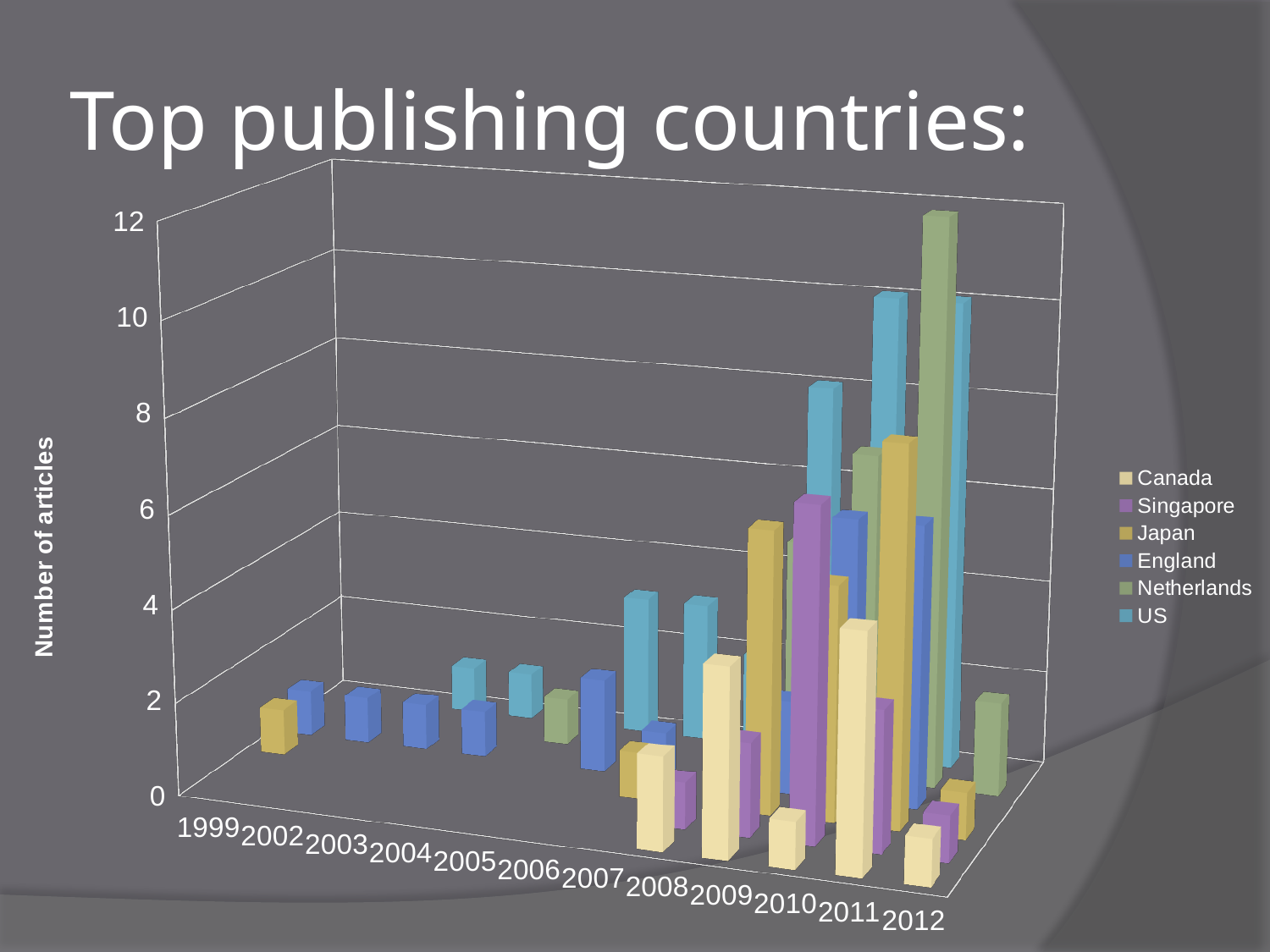
What kind of chart is shown on the slide? bar chart Is the value for US in 2011 greater or less than 8? greater How many series does the legend list? 6 Which country has the tallest bar in 2012? Netherlands Is the value for Netherlands in 2012 greater or less than 10? less How many years are shown along the x axis? 12 In 2012, which is larger: the value for Netherlands or the value for US? Netherlands What is the title of the chart? Top publishing countries: Which year contains the tallest bar in the chart? 2011 What is the label on the vertical axis? Number of articles Which is larger: the value for Japan in 2010 or the value for Japan in 1999? Japan in 2010